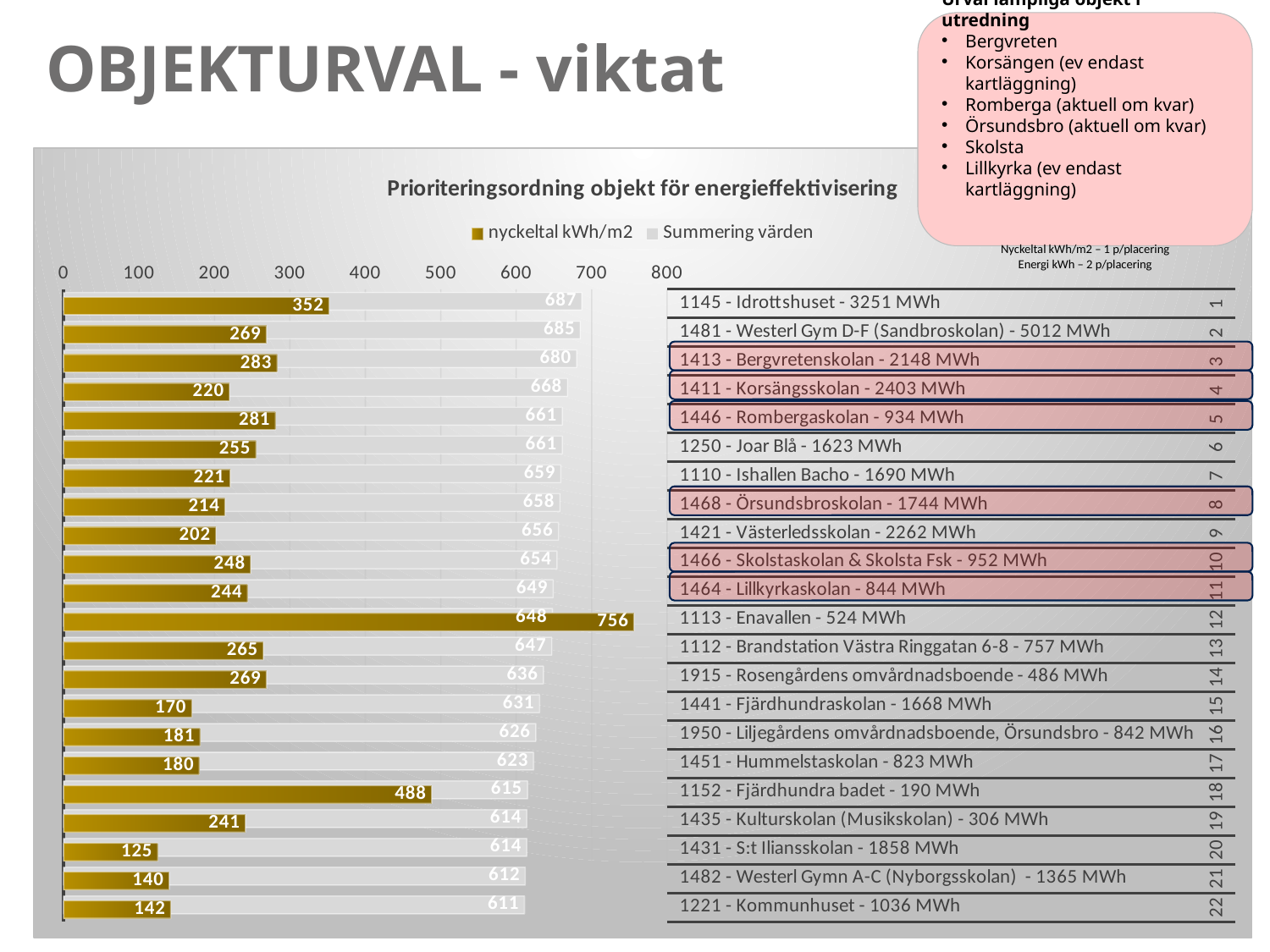
Which object has the lowest nyckeltal kWh/m2 value? 1431 - S:t Iliansskolan How many series does the chart legend list? 2 How many objects (categories) are plotted in the chart? 22 Do the Summering värden values rise or fall going down the list from rank 1 to rank 22? Fall What is the nyckeltal kWh/m2 value for 1145 - Idrottshuset? 352 Which has a larger nyckeltal kWh/m2 value, 1446 - Rombergaskolan or 1411 - Korsängsskolan? 1446 - Rombergaskolan What is the Summering värden value for 1413 - Bergvretenskolan? 680 What is the title of the chart? Prioriteringsordning objekt för energieffektivisering What is the nyckeltal kWh/m2 value for 1152 - Fjärdhundra badet? 488 Which object has the highest nyckeltal kWh/m2 value? 1113 - Enavallen What is the difference between the Summering värden values for 1145 - Idrottshuset and 1221 - Kommunhuset? 76 What kind of chart is shown on the slide? Bar chart